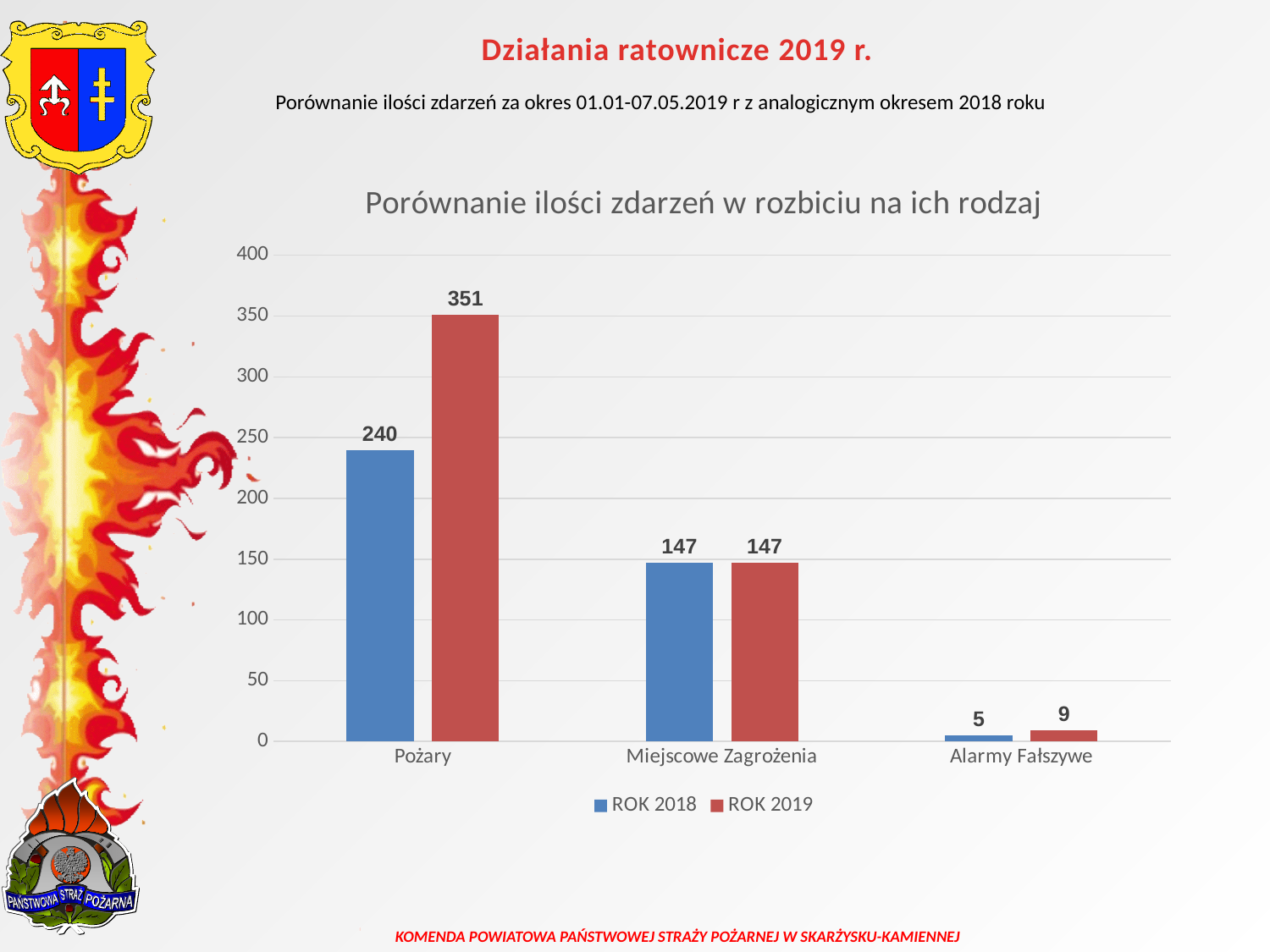
Which category has the highest value in the ROK 2019 series? Pożary Which category has the lowest value in the ROK 2018 series? Alarmy Fałszywe How many categories are shown on the x axis? 3 What is the value for Alarmy Fałszywe in the ROK 2018 series? 5 Which is larger for Alarmy Fałszywe: the ROK 2018 value or the ROK 2019 value? ROK 2019 What is the value for Pożary in the ROK 2019 series? 351 What is the value for Miejscowe Zagrożenia in the ROK 2019 series? 147 What is the title of the chart? Porównanie ilości zdarzeń w rozbiciu na ich rodzaj What kind of chart is shown on the slide? bar chart How many series does the legend list? 2 What is the difference between the ROK 2019 and ROK 2018 values for Pożary? 111 Is the ROK 2018 value for Pożary greater or less than 200? greater